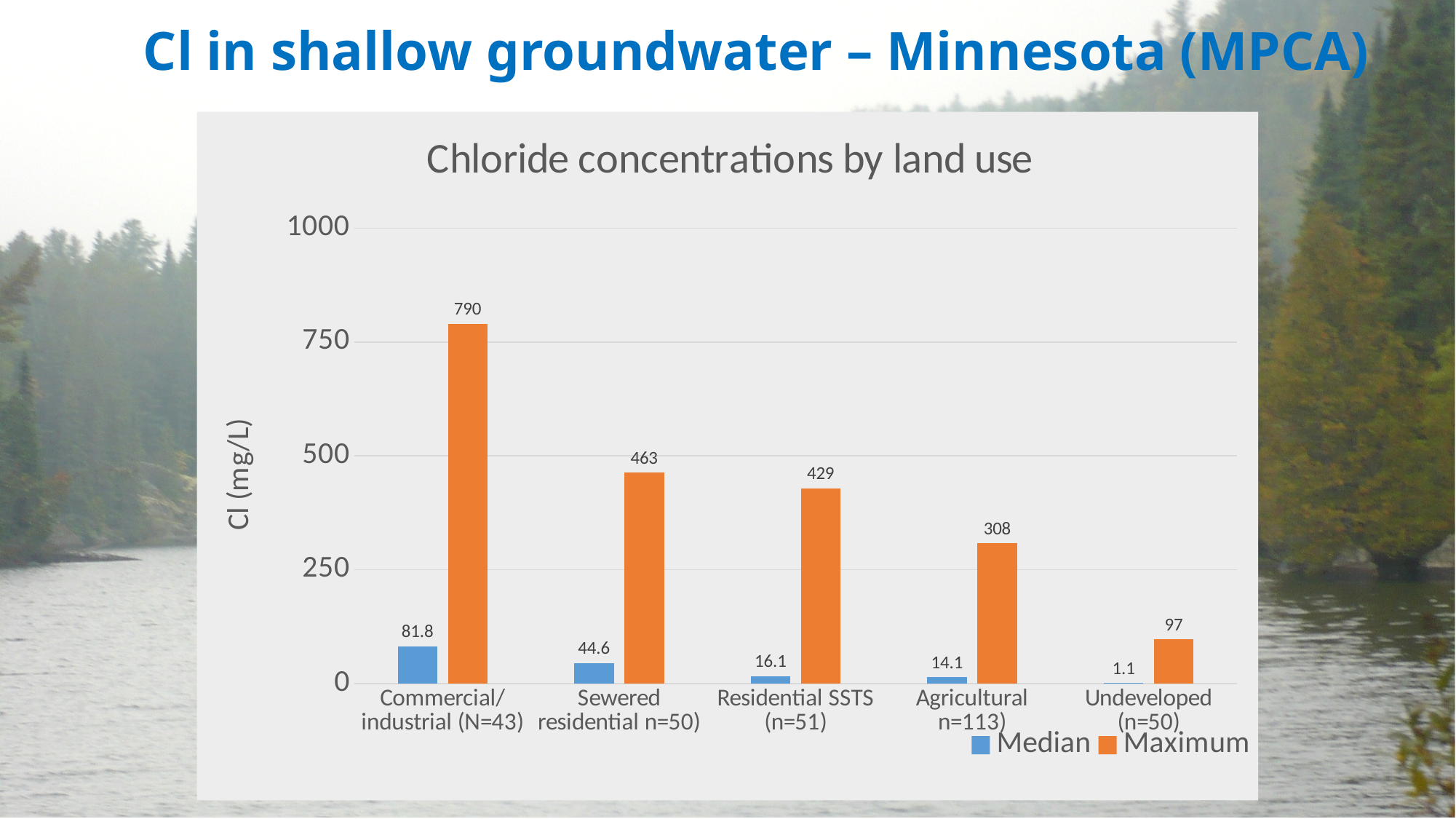
Which land use category has the highest Maximum chloride concentration? Commercial/industrial (N=43) Which land use category has the lowest Median chloride concentration? Undeveloped (n=50) How many series does the legend list? 2 What is the difference between the Maximum values for Sewered residential n=50) and Residential SSTS (n=51)? 34 Which is larger: the Median for Residential SSTS (n=51) or the Median for Agricultural n=113)? Residential SSTS (n=51) Is the Maximum value for Undeveloped (n=50) greater or less than 250? less What is the Maximum value for Agricultural n=113)? 308 What is the Maximum chloride concentration for Commercial/industrial (N=43)? 790 What type of chart is shown on the slide? bar chart What is the Median value for Undeveloped (n=50)? 1.1 How many land use categories are shown on the x axis? 5 What is the Median chloride concentration for Sewered residential n=50)? 44.6